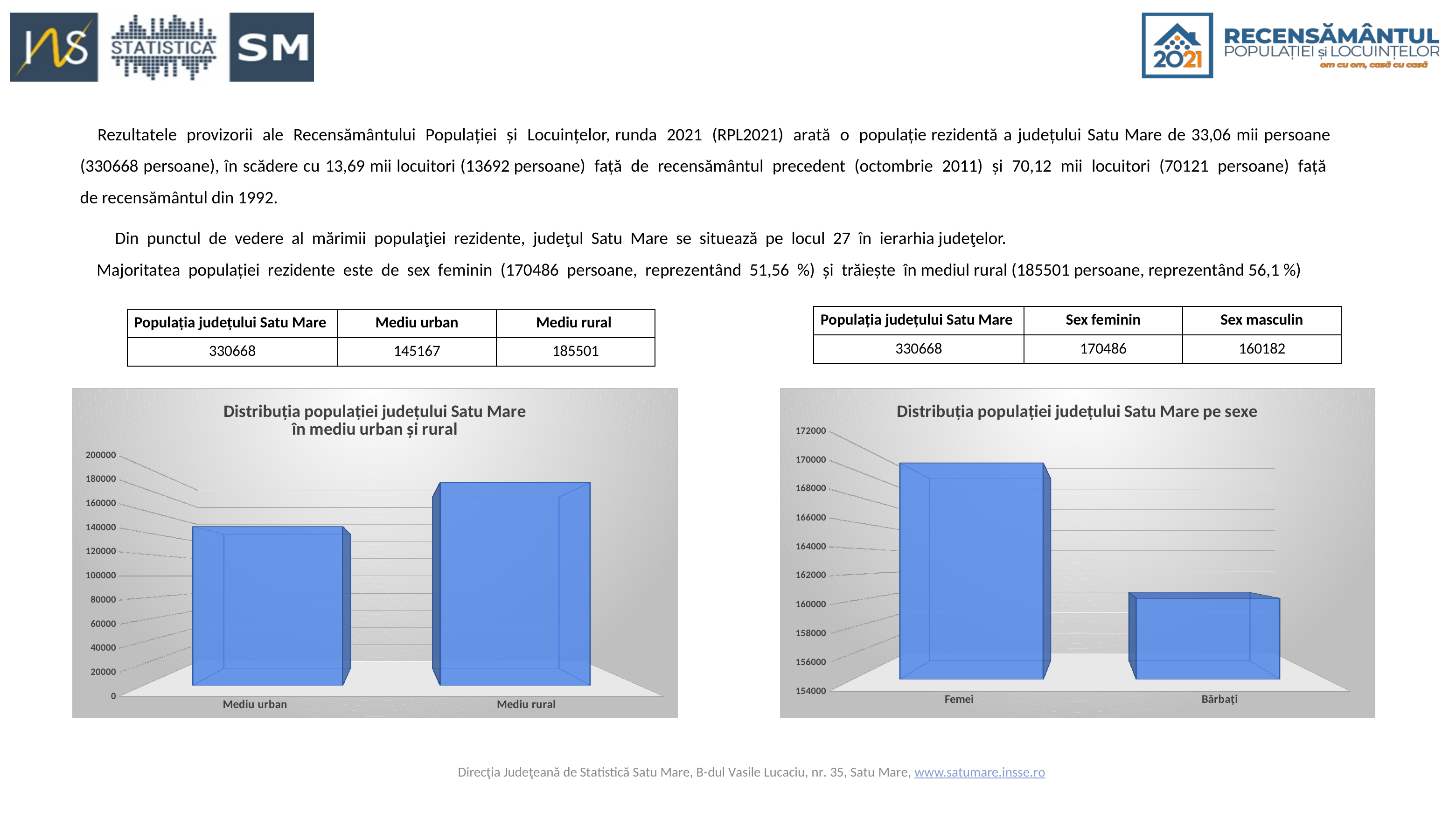
In the left chart, is the value for Mediu urban greater or less than 160000? less In the right chart, which category has the highest value? Femei In the right chart, which is larger, the value for Femei or the value for Bărbați? Femei In the left chart, which category has the highest value? Mediu rural How many categories are shown in the left chart? 2 What type of chart is the right chart, 'Distribuția populației județului Satu Mare pe sexe'? bar chart In the left chart, which category has the lowest value? Mediu urban What type of chart is the left chart, 'Distribuția populației județului Satu Mare în mediu urban și rural'? bar chart In the right chart, is the value for Femei greater or less than 168000? greater What is the title of the right chart? Distribuția populației județului Satu Mare pe sexe In the right chart, is the value for Bărbați greater or less than 162000? less